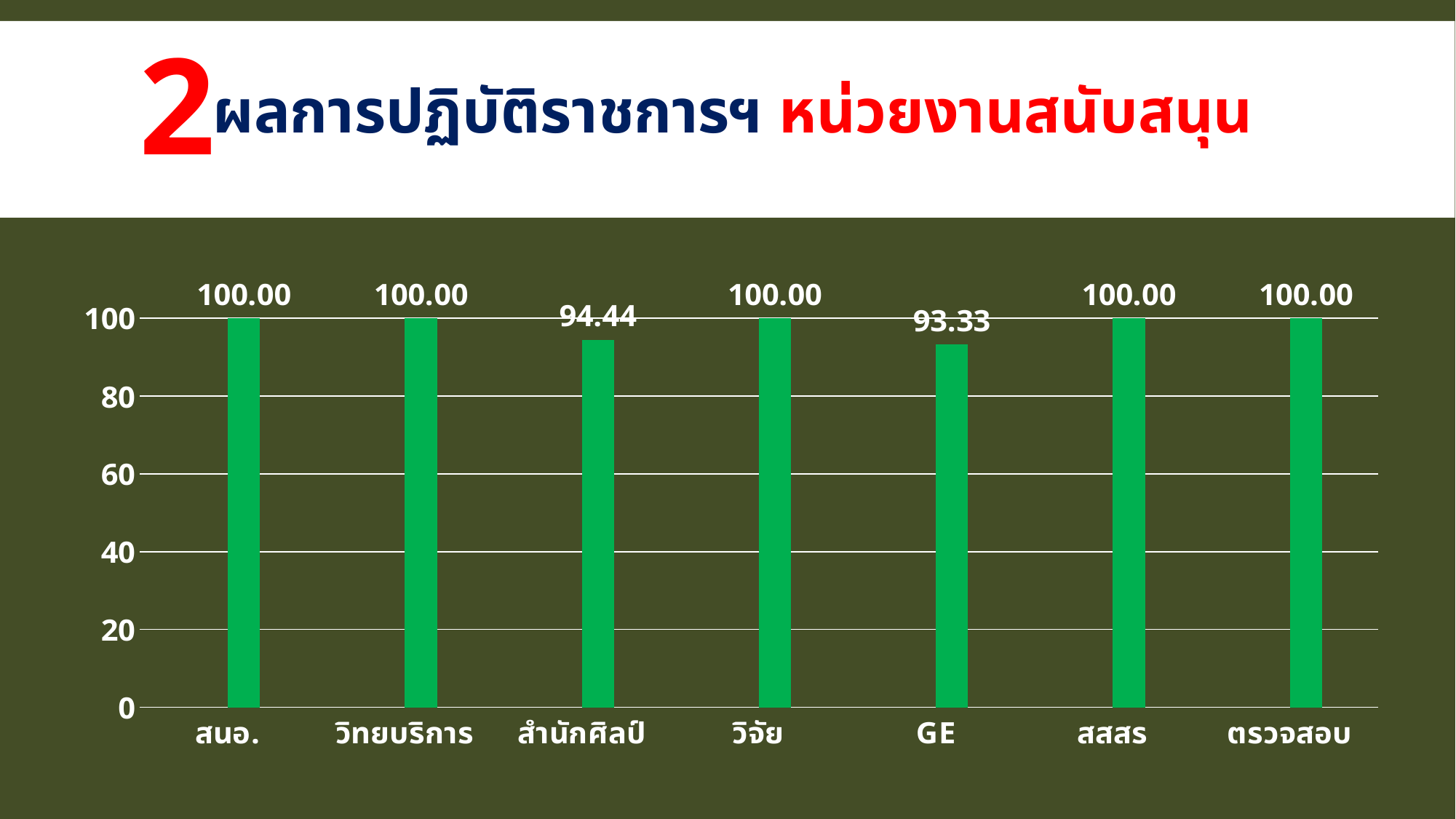
What is the value for สำนักศิลป์? 94.44 What is the value for ตรวจสอบ? 100.00 How many categories have a value of 100.00? 5 Which category has the lowest value? GE Is the value for GE greater or less than 80? greater Which is larger, the value for สำนักศิลป์ or the value for GE? สำนักศิลป์ What is the difference between the values for สนอ. and GE? 6.67 What kind of chart is shown on the slide? bar chart What is the value for GE? 93.33 How many categories are shown on the x axis? 7 What is the value for วิจัย? 100.00 What is the difference between the values for สำนักศิลป์ and GE? 1.11